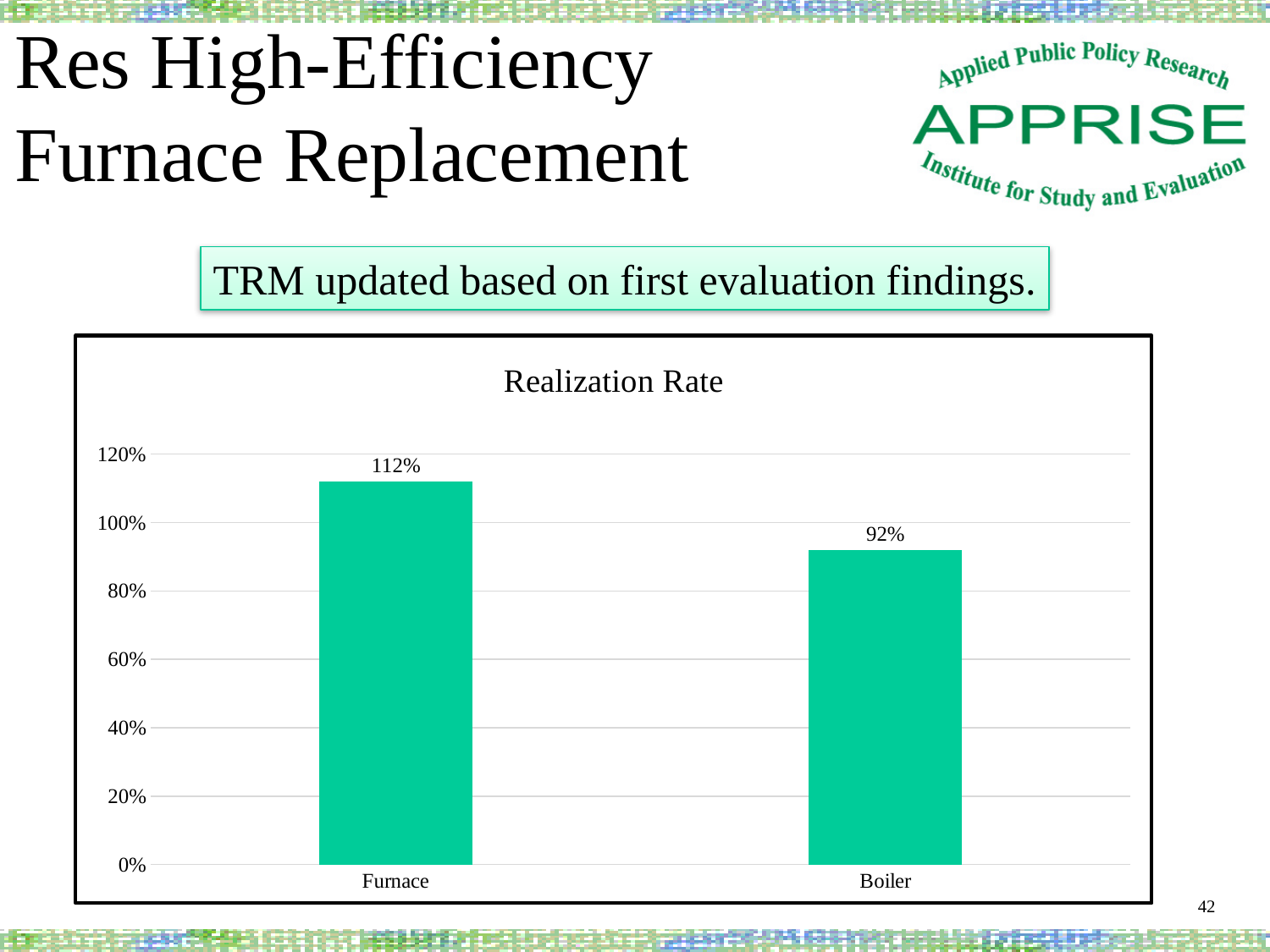
How many categories are shown in the chart? 2 What kind of chart is shown on the slide? bar chart Which has a larger realization rate, Furnace or Boiler? Furnace Which category has the highest realization rate? Furnace Is the realization rate for Boiler greater or less than 100%? less What is the title of the chart? Realization Rate What is the difference between the realization rates for Furnace and Boiler? 20% Which category has the lowest realization rate? Boiler What is the realization rate for Boiler? 92% Is the realization rate for Furnace greater or less than 100%? greater What is the highest value shown on the vertical axis? 120% What is the realization rate for Furnace? 112%